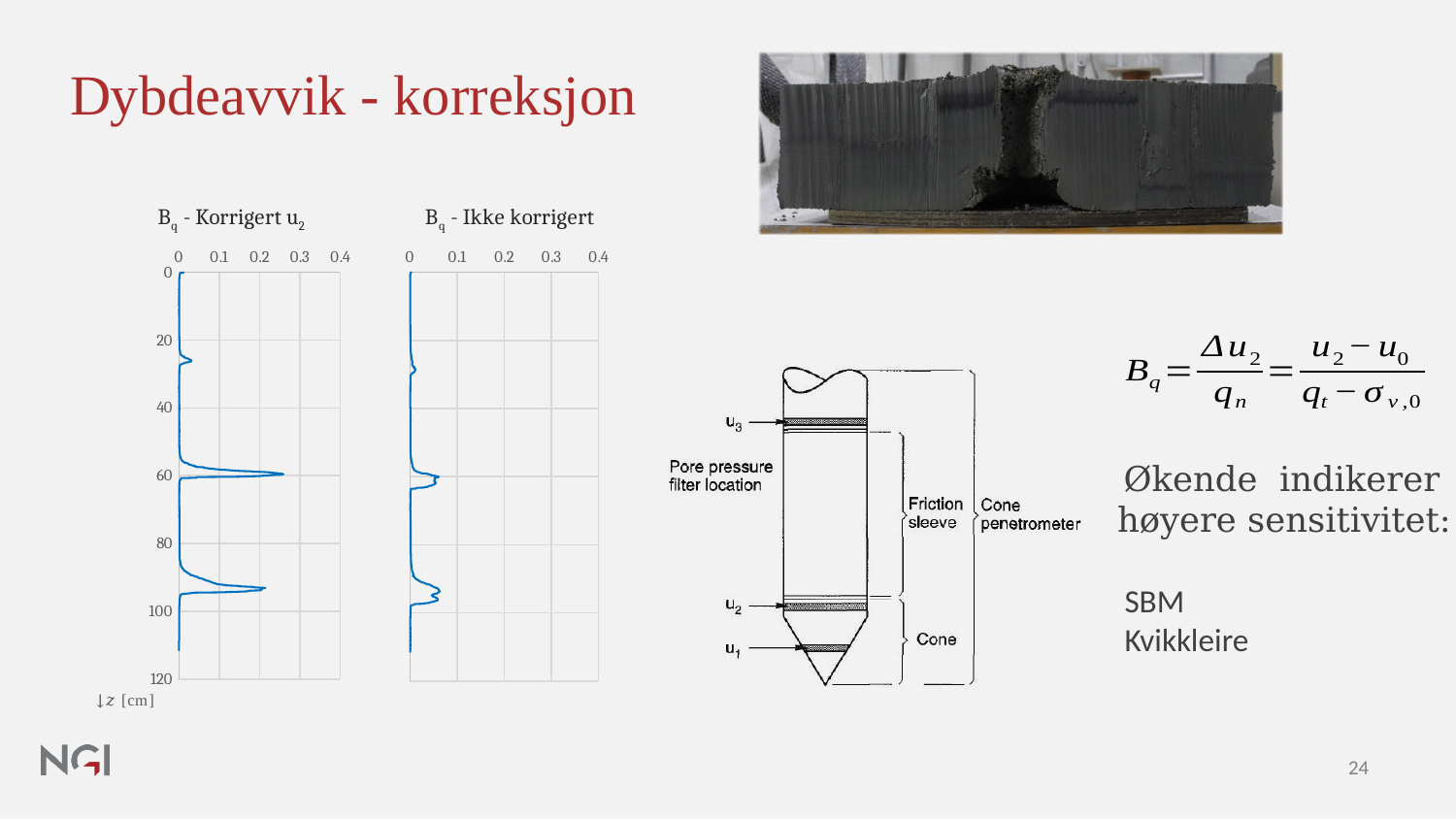
In the "Bq - Ikke korrigert" chart, is the peak value near a depth of 60 cm greater or less than 0.1? less Which chart shows the larger peak value near a depth of 60 cm, "Bq - Korrigert u2" or "Bq - Ikke korrigert"? Bq - Korrigert u2 In the "Bq - Korrigert u2" chart, what is the largest value shown on the horizontal axis? 0.4 What is the title of the second (right-hand) line chart on the slide? Bq - Ikke korrigert What kind of chart is the "Bq - Korrigert u2" chart on the left of the slide? line chart In the "Bq - Korrigert u2" chart, is the peak value near a depth of 60 cm greater or less than 0.3? less How many line charts are shown on the slide? 2 What unit is given for the depth axis z of the line charts? cm In the "Bq - Korrigert u2" chart, which peak is higher: the one near 60 cm depth or the one near 95 cm depth? the one near 60 cm In the "Bq - Korrigert u2" chart, what is the largest depth value shown on the vertical axis? 120 In the "Bq - Korrigert u2" chart, is the peak value near a depth of 60 cm greater or less than 0.2? greater